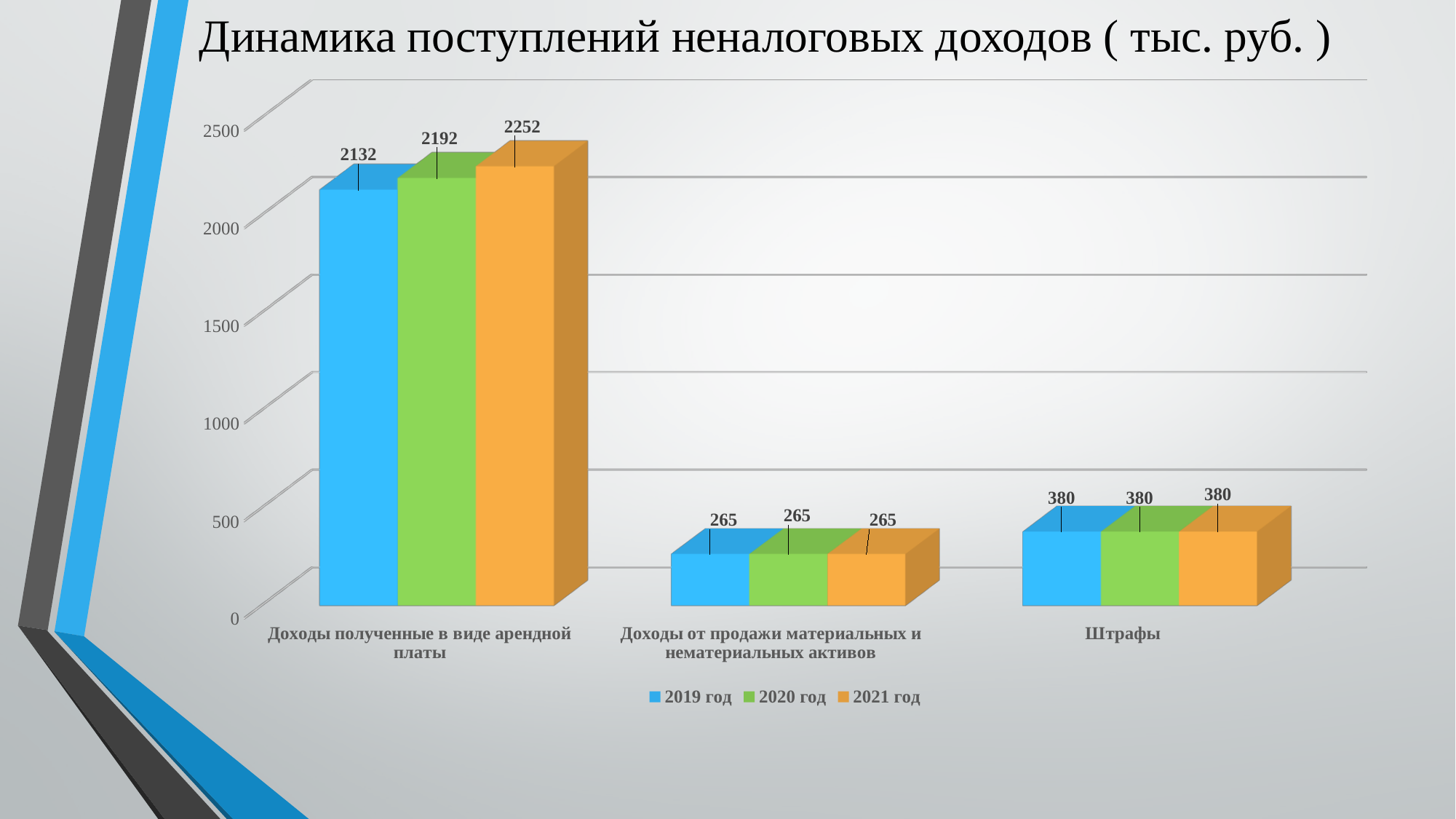
Which category has the lowest value for 2019 год? Доходы от продажи материальных и нематериальных активов What is the value for 2021 год in the category Доходы от продажи материальных и нематериальных активов? 265 What is the value for 2019 год in the category Доходы полученные в виде арендной платы? 2132 Which category has the highest value for 2021 год? Доходы полученные в виде арендной платы What is the value for 2021 год in the category Доходы полученные в виде арендной платы? 2252 Which is larger for Штрафы: the 2019 год value or the 2021 год value? They are equal (380) What is the value for 2020 год in the category Штрафы? 380 How many categories are shown on the x axis? 3 What kind of chart is shown on the slide? Bar chart What is the difference between the 2021 год and 2019 год values for Доходы полученные в виде арендной платы? 120 How many series does the legend list? 3 What is the title of the chart? Динамика поступлений неналоговых доходов ( тыс. руб. )